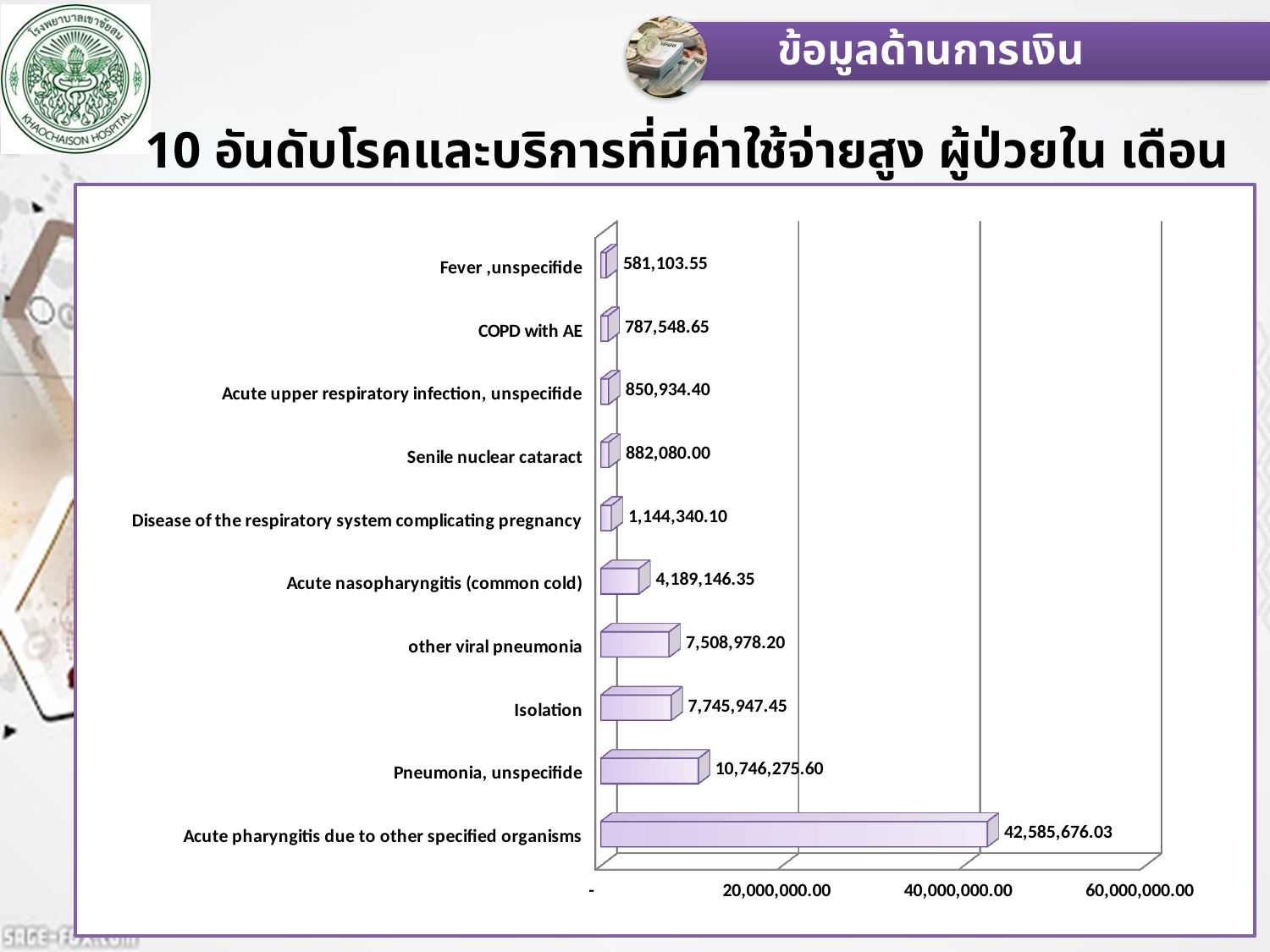
Which category has the lowest value? Fever ,unspecifide How many categories are shown in the chart? 10 What is the value for Isolation? 7,745,947.45 What is the value for Pneumonia, unspecifide? 10,746,275.60 Which category has the highest value? Acute pharyngitis due to other specified organisms What is the difference between the values for Acute pharyngitis due to other specified organisms and Pneumonia, unspecifide? 31,839,400.43 Is the value for Acute pharyngitis due to other specified organisms greater or less than 40,000,000.00? greater What is the difference between the values for Isolation and other viral pneumonia? 236,969.25 What is the value for Senile nuclear cataract? 882,080.00 Which is larger, the value for COPD with AE or the value for Senile nuclear cataract? Senile nuclear cataract What kind of chart is shown on the slide? bar chart What is the value for Acute nasopharyngitis (common cold)? 4,189,146.35